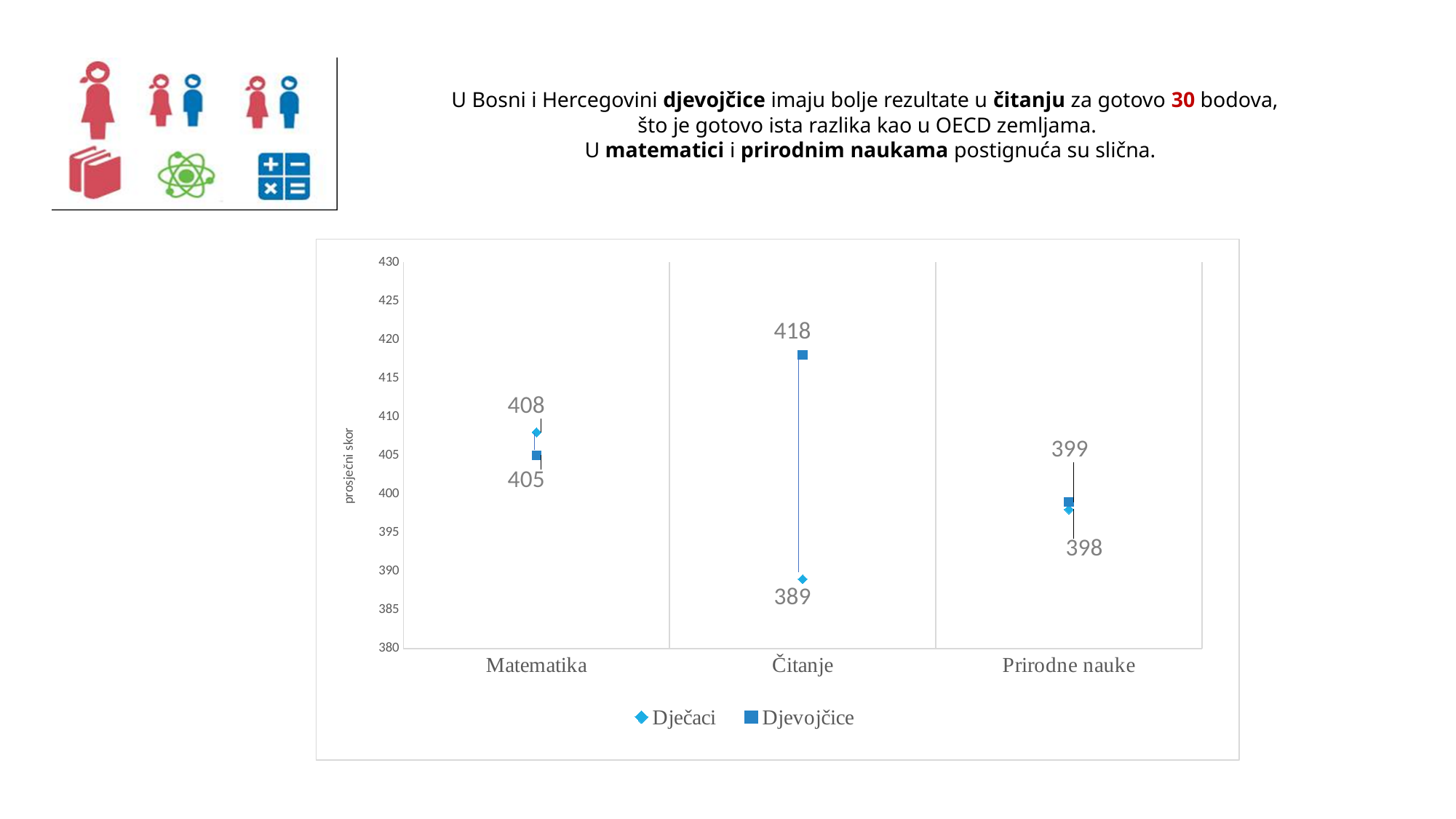
In which category do Djevojčice have the highest value? Čitanje How many series does the legend list? 2 What is the difference between Djevojčice and Dječaci in Čitanje? 29 How many categories are shown on the x axis? 3 What is the value for Djevojčice in Matematika? 405 In which category do Dječaci have the lowest value? Čitanje What is the value for Djevojčice in Prirodne nauke? 399 What is the label of the vertical axis? prosječni skor What is the value for Djevojčice in Čitanje? 418 What is the value for Dječaci in Čitanje? 389 What is the value for Dječaci in Matematika? 408 Which is larger in Matematika, the value for Dječaci or for Djevojčice? Dječaci